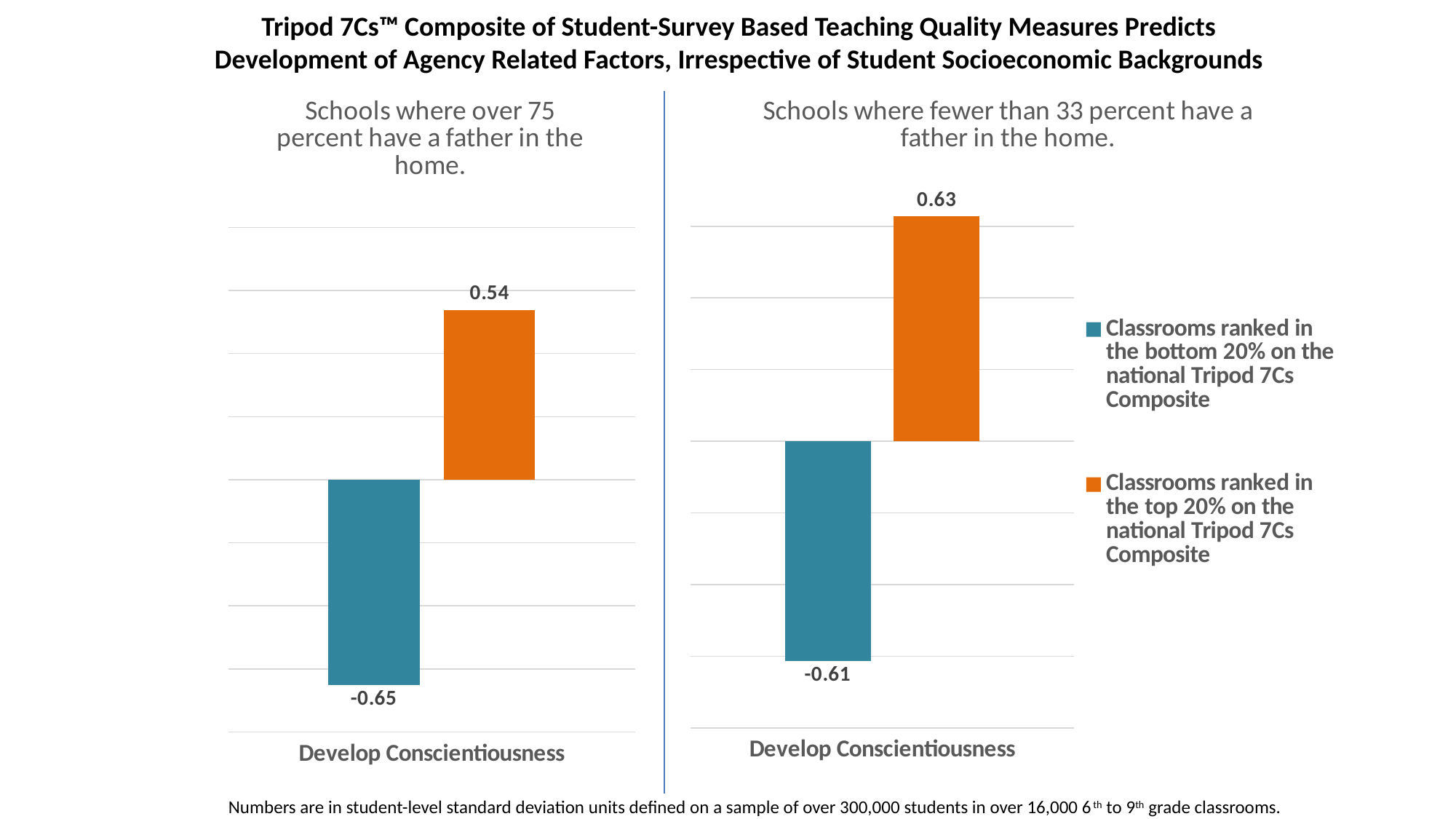
In the right chart (Schools where fewer than 33 percent have a father in the home), which series has the lowest value? Classrooms ranked in the bottom 20% on the national Tripod 7Cs Composite What is the category label on the x axis of the right chart (Schools where fewer than 33 percent have a father in the home)? Develop Conscientiousness In the left chart (Schools where over 75 percent have a father in the home), what is the difference between the top 20% value and the bottom 20% value? 1.19 In the right chart (Schools where fewer than 33 percent have a father in the home), what is the difference between the top 20% value and the bottom 20% value? 1.24 How many series does the legend list? 2 In the left chart (Schools where over 75 percent have a father in the home), what is the value for classrooms ranked in the bottom 20% on the national Tripod 7Cs Composite? -0.65 In the right chart (Schools where fewer than 33 percent have a father in the home), what is the value for classrooms ranked in the top 20% on the national Tripod 7Cs Composite? 0.63 In the left chart (Schools where over 75 percent have a father in the home), which series has the higher value? Classrooms ranked in the top 20% on the national Tripod 7Cs Composite What type of chart is the left chart (Schools where over 75 percent have a father in the home)? Bar chart Which chart shows the higher value for classrooms ranked in the top 20%: the left chart (over 75 percent) or the right chart (fewer than 33 percent)? The right chart (fewer than 33 percent) In the left chart (Schools where over 75 percent have a father in the home), what is the value for classrooms ranked in the top 20% on the national Tripod 7Cs Composite? 0.54 In the right chart (Schools where fewer than 33 percent have a father in the home), what is the value for classrooms ranked in the bottom 20% on the national Tripod 7Cs Composite? -0.61